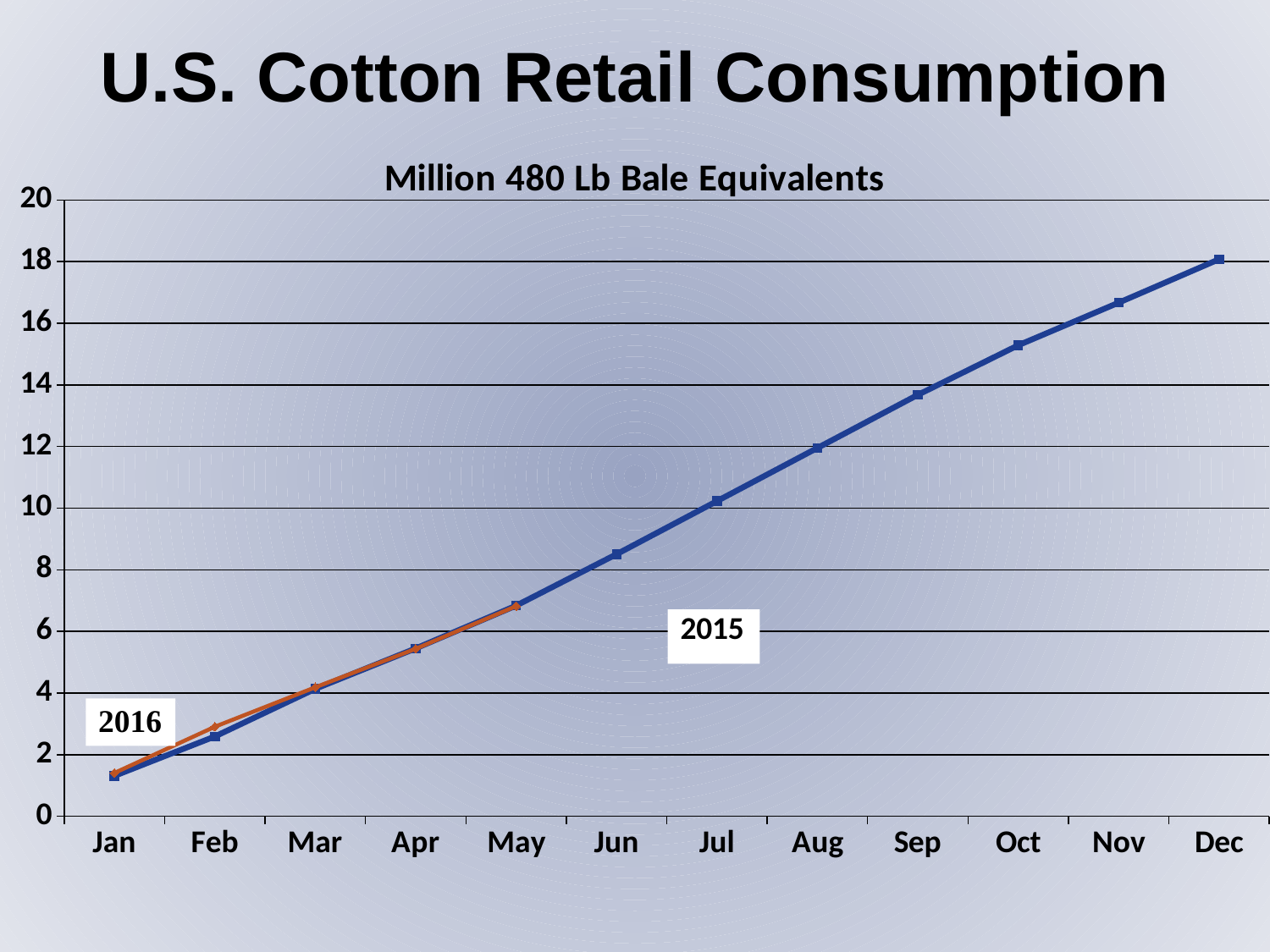
In which month does the 2015 series reach its highest value? Dec Is the 2016 value for Feb greater or less than 2? greater What kind of chart is shown on the slide? line chart In which month is the 2015 series at its lowest value? Jan What unit is given in the chart's subtitle? Million 480 Lb Bale Equivalents Is the 2015 value for Apr greater or less than 6? less Is the 2015 value for Sep greater or less than 12? greater Do the values for the 2015 series rise or fall from Jan to Dec? rise How many data series are plotted on the chart? 2 Which is larger, the 2015 value for Dec or the 2015 value for Jun? Dec How many months are shown along the x axis? 12 Which two years are labelled on the chart? 2015 and 2016